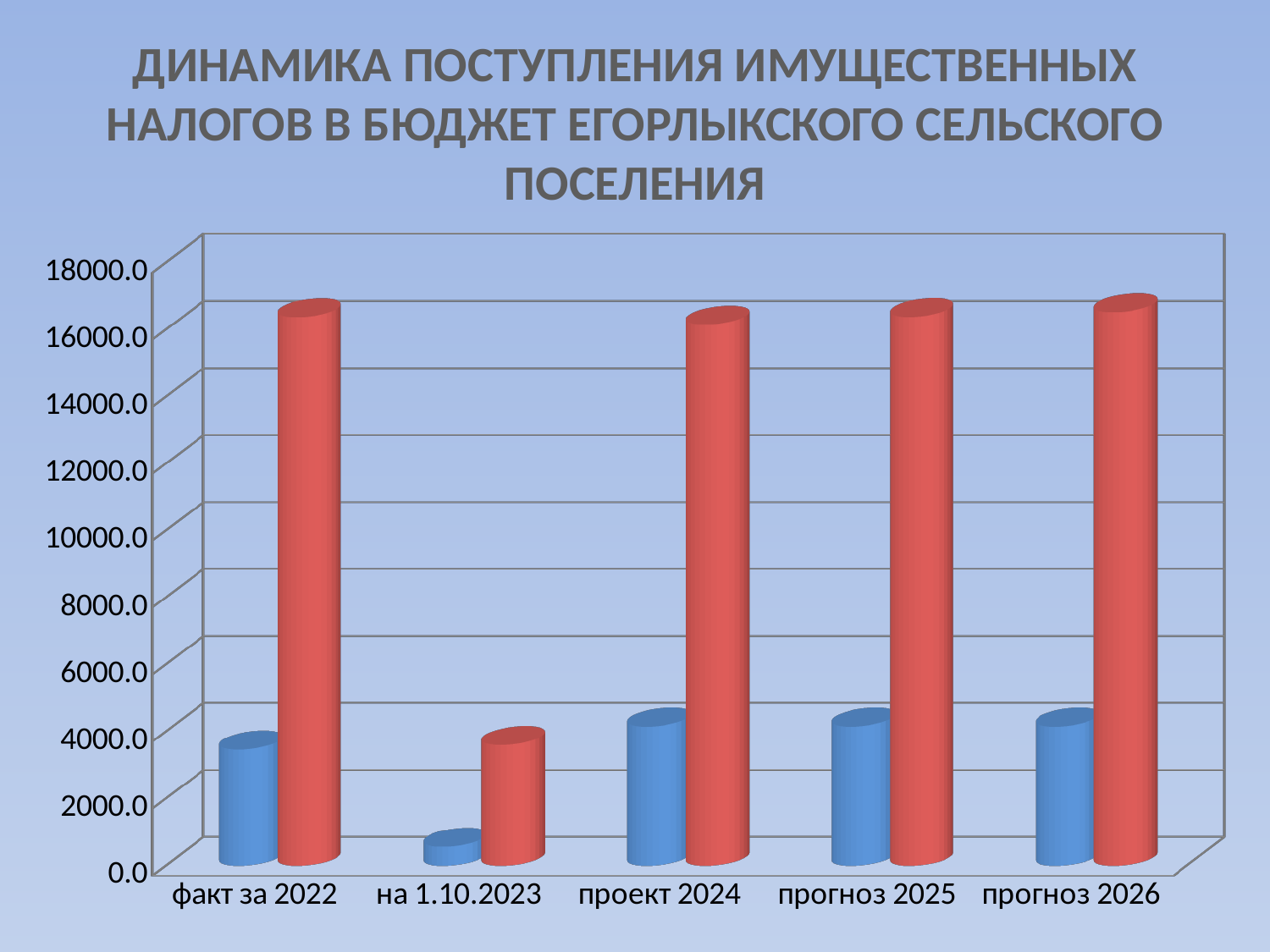
Is the blue bar for на 1.10.2023 greater or less than 2000.0? less Which category has the lowest blue bar? на 1.10.2023 Is the red bar for на 1.10.2023 greater or less than 6000.0? less How many categories are shown on the x axis of the chart? 5 Which blue bar is larger: факт за 2022 or на 1.10.2023? факт за 2022 For факт за 2022, which bar is larger, the red one or the blue one? the red one How many data series (bar colours) are plotted in the chart? 2 What is the title of the chart on the slide? ДИНАМИКА ПОСТУПЛЕНИЯ ИМУЩЕСТВЕННЫХ НАЛОГОВ В БЮДЖЕТ ЕГОРЛЫКСКОГО СЕЛЬСКОГО ПОСЕЛЕНИЯ What kind of chart is shown on the slide? bar chart Which category has the lowest red bar? на 1.10.2023 Is the red bar for факт за 2022 greater or less than 14000.0? greater